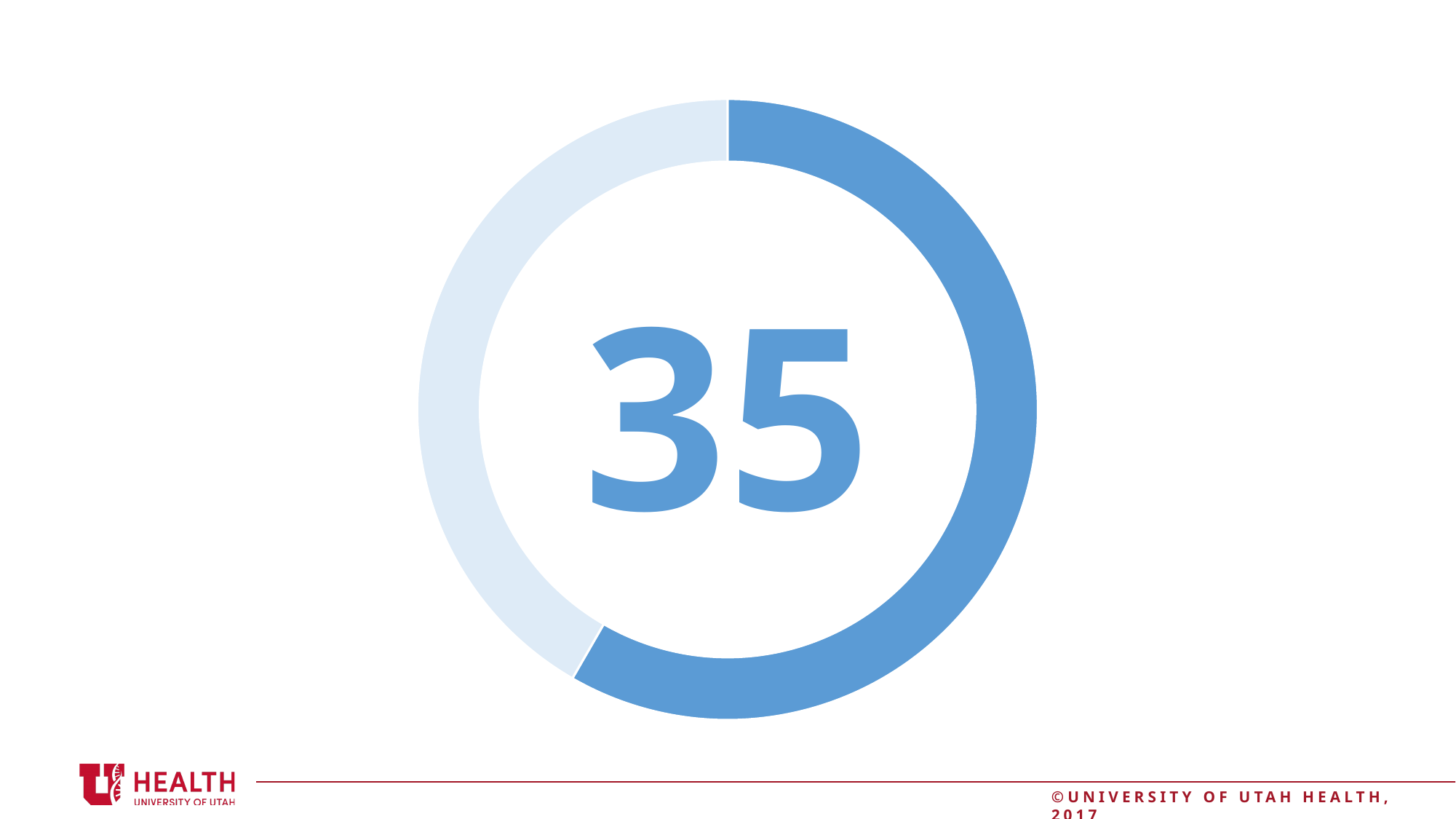
What number is displayed in the centre of the doughnut chart? 35 Does the doughnut chart have a legend? No Which segment of the doughnut chart is larger, the dark blue one or the light blue one? The dark blue one How many segments does the doughnut chart have? 2 What kind of chart is shown on the slide? Doughnut chart Which segment of the doughnut chart is the smallest? The light blue segment